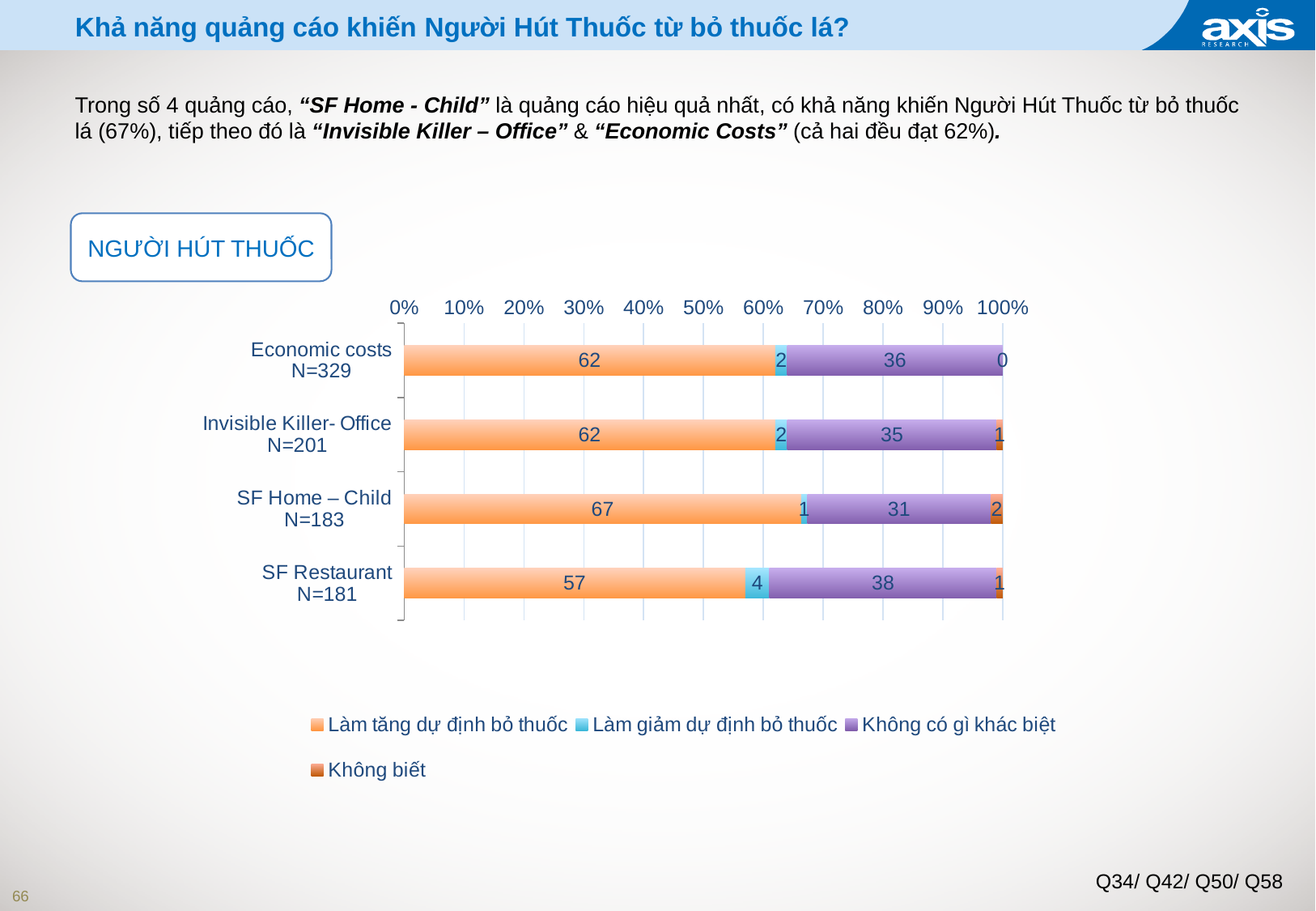
What kind of chart is shown on the slide? Stacked bar chart Which is larger: the "Không có gì khác biệt" value for Economic costs or for SF Home – Child? Economic costs What is the value of "Làm tăng dự định bỏ thuốc" for SF Home – Child? 67 Which advertisement has the highest value for "Làm tăng dự định bỏ thuốc"? SF Home – Child Which advertisement has the lowest value for "Làm tăng dự định bỏ thuốc"? SF Restaurant What is the value of "Không biết" for Economic costs? 0 What is the value of "Làm giảm dự định bỏ thuốc" for SF Restaurant? 4 What is the difference between the "Làm tăng dự định bỏ thuốc" values for SF Home – Child and SF Restaurant? 10 What is the sample size (N) shown for Invisible Killer- Office? N=201 How many series does the legend list? 4 What is the value of "Không có gì khác biệt" for SF Restaurant? 38 How many advertisements (categories) are plotted in the chart? 4